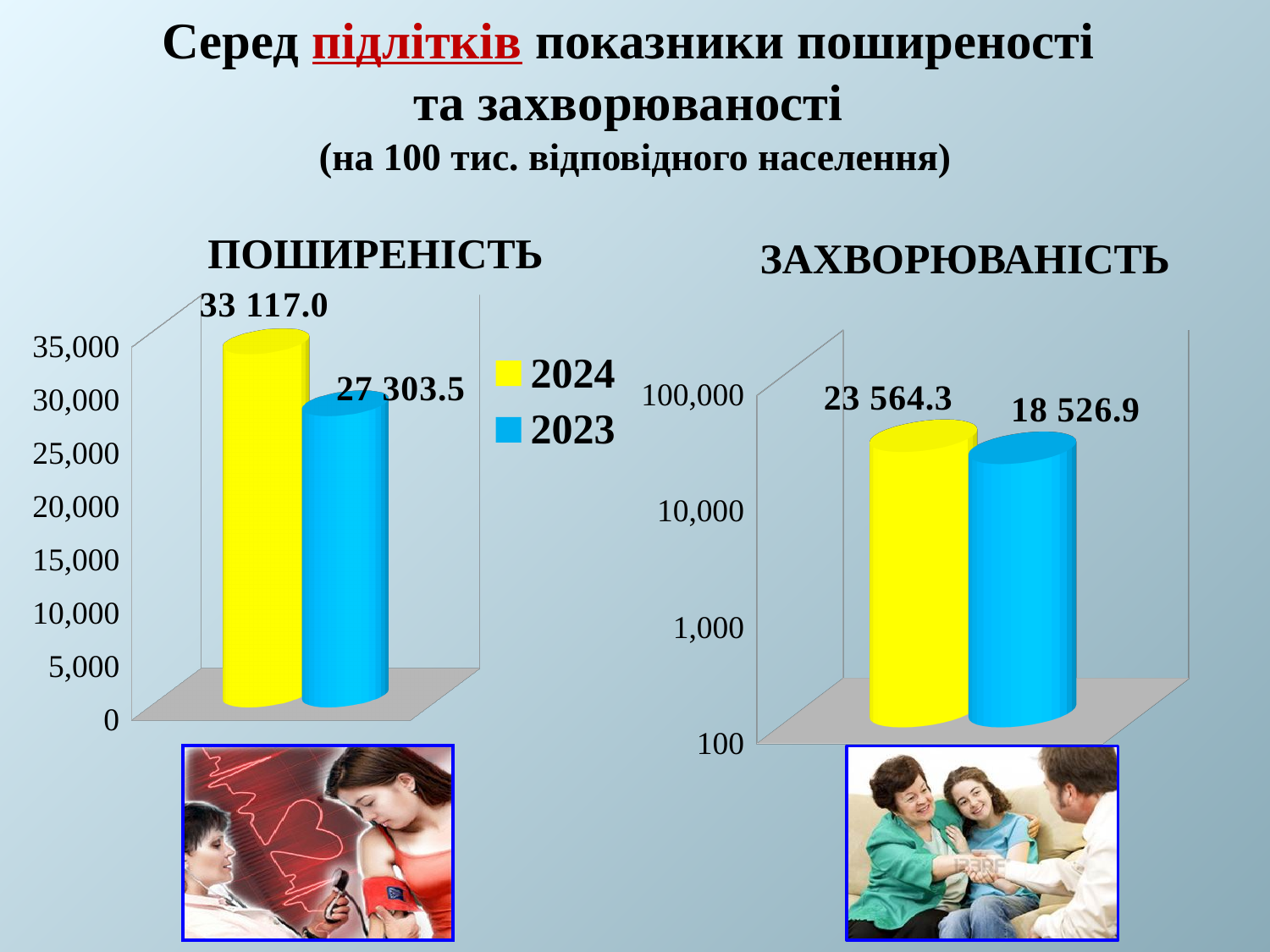
In the ПОШИРЕНІСТЬ chart, which year has the higher value? 2024 In the ПОШИРЕНІСТЬ chart, what is the difference between the 2024 and 2023 values? 5 813.5 In the ЗАХВОРЮВАНІСТЬ chart, what is the value for 2023? 18 526.9 In the ЗАХВОРЮВАНІСТЬ chart, what is the difference between the 2024 and 2023 values? 5 037.4 In the ПОШИРЕНІСТЬ chart, what is the value for 2024? 33 117.0 In the ЗАХВОРЮВАНІСТЬ chart, which year has the lower value? 2023 Which colour represents 2023 in the legend? blue In the ПОШИРЕНІСТЬ chart, what is the value for 2023? 27 303.5 What kind of chart is the ЗАХВОРЮВАНІСТЬ chart? bar chart In the ЗАХВОРЮВАНІСТЬ chart, what is the value for 2024? 23 564.3 How many series does the legend list? 2 In the ПОШИРЕНІСТЬ chart, is the value for 2023 greater or less than 30,000? less